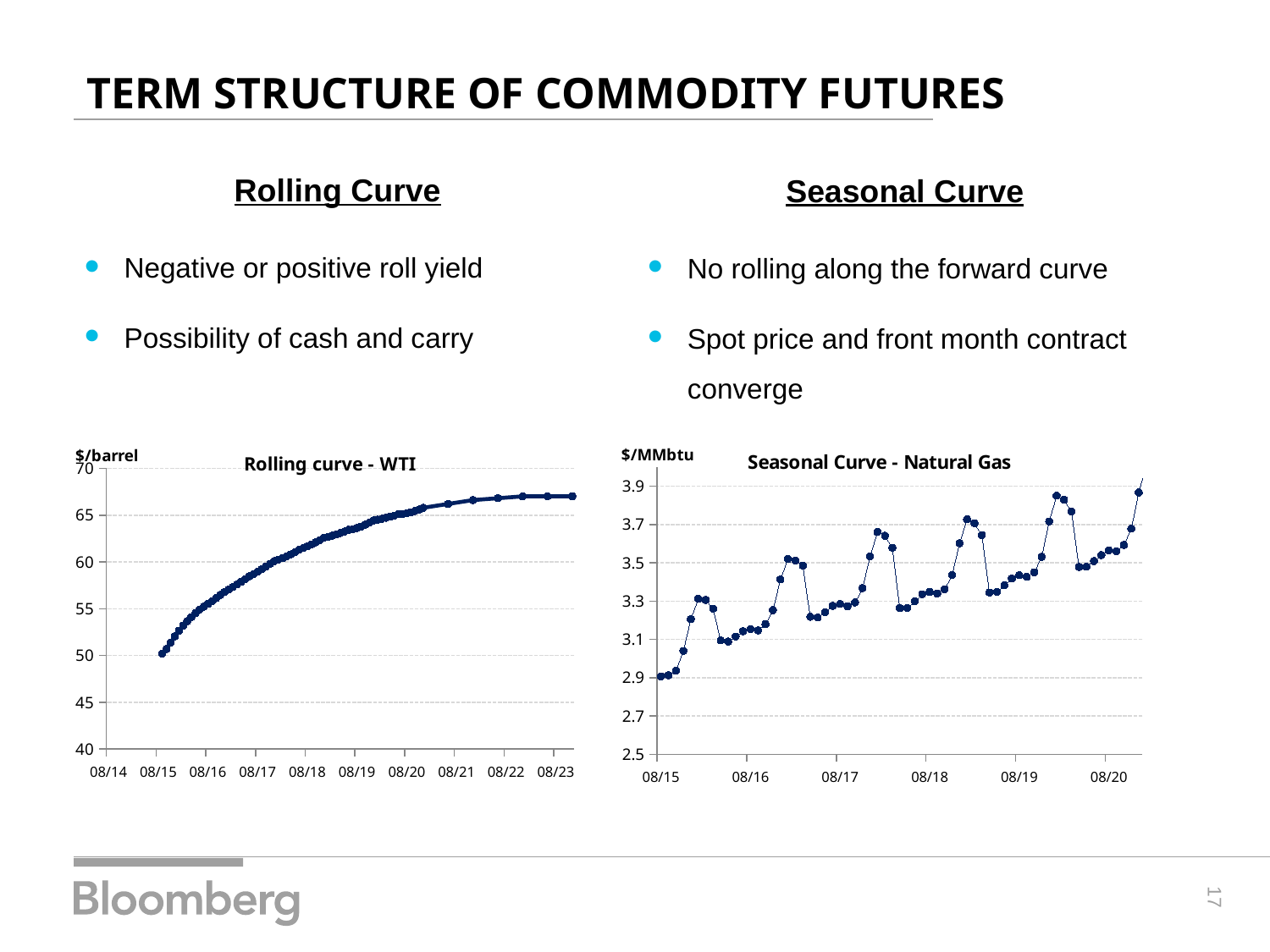
What unit is shown on the y axis of the 'Rolling curve - WTI' chart? $/barrel In the 'Rolling curve - WTI' chart, is the value at 08/23 greater or less than 65? greater What kind of chart is the 'Rolling curve - WTI' chart? line chart What unit is shown on the y axis of the 'Seasonal Curve - Natural Gas' chart? $/MMbtu In the 'Rolling curve - WTI' chart, do the values rise or fall along the x axis from 08/15 to 08/23? rise In the 'Seasonal Curve - Natural Gas' chart, is the value at 08/15 greater or less than 3.1? less In the 'Rolling curve - WTI' chart, is the value at 08/18 greater or less than 60? greater What kind of chart is the 'Seasonal Curve - Natural Gas' chart? line chart In the 'Seasonal Curve - Natural Gas' chart, is the overall direction of the values from 08/15 to 08/20 rising or falling? rising